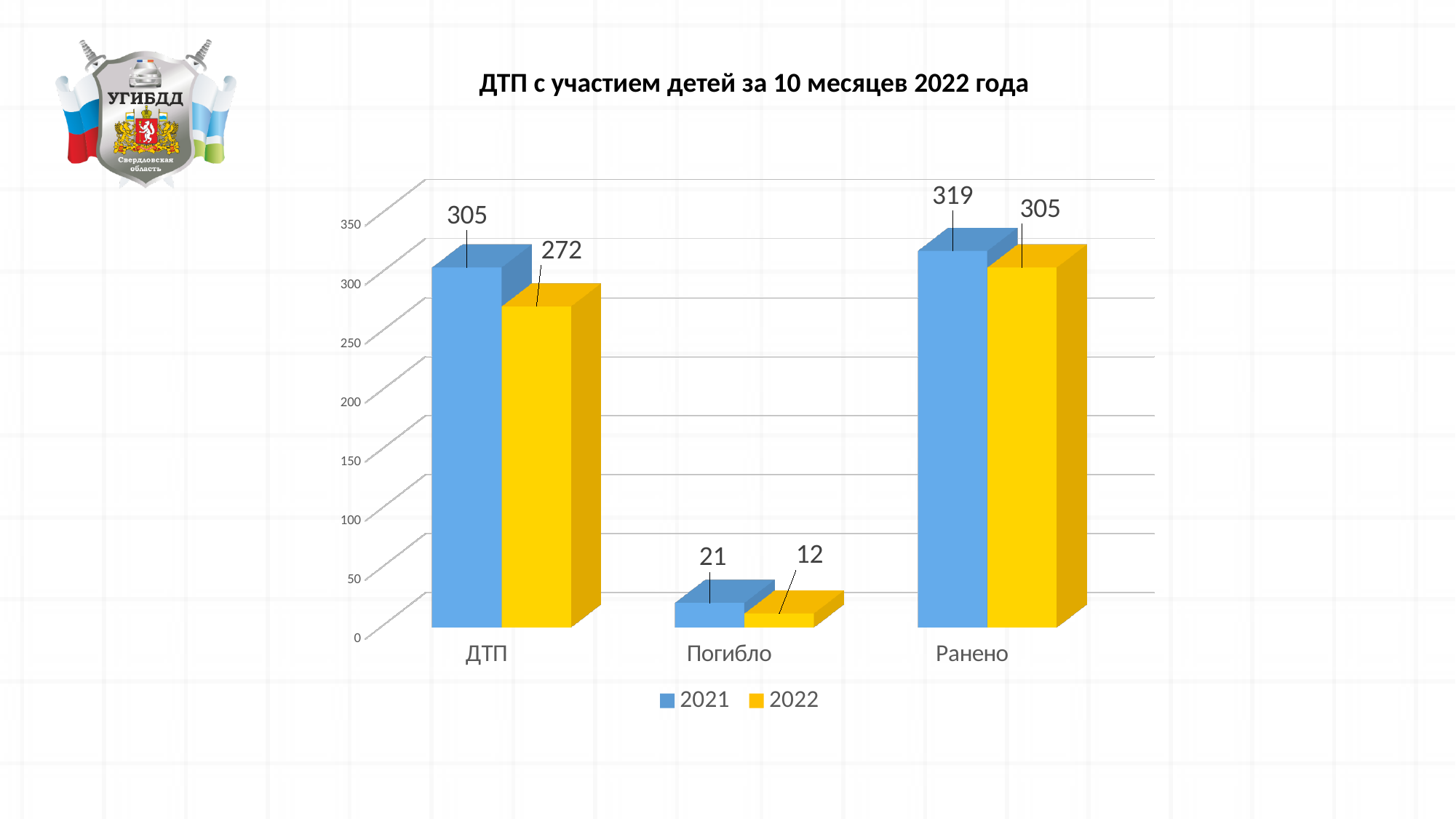
What is the value for Погибло in the 2022 series? 12 What is the value for ДТП in the 2021 series? 305 What is the difference between the 2021 and 2022 values for ДТП? 33 How many series does the legend list? 2 Which category has the lowest value in the 2022 series? Погибло What is the title of the chart? ДТП с участием детей за 10 месяцев 2022 года Which category has the highest value in the 2021 series? Ранено What is the value for Погибло in the 2021 series? 21 What is the value for ДТП in the 2022 series? 272 What is the value for Ранено in the 2022 series? 305 Which is larger for Погибло: the 2021 value or the 2022 value? 2021 What is the difference between the 2021 and 2022 values for Ранено? 14